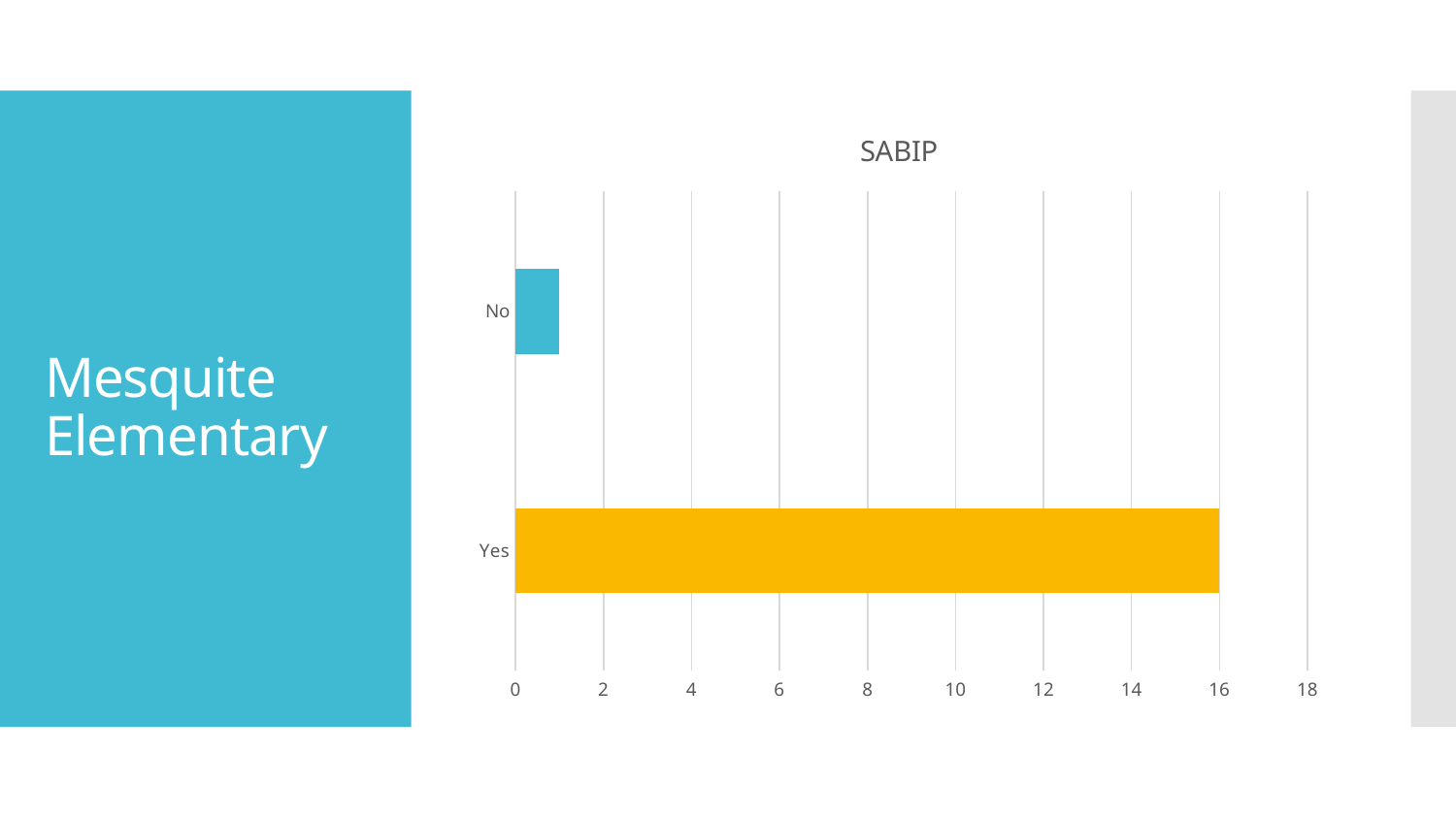
What is the highest value shown on the horizontal axis of the SABIP chart? 18 Which is larger in the SABIP chart, the value for Yes or the value for No? Yes What kind of chart is shown on the slide? bar chart Which category has the lowest value in the SABIP chart? No Is the value for No greater or less than 2 in the SABIP chart? less What colour is the bar for Yes in the SABIP chart? yellow What is the title of the chart on the slide? SABIP What is the value for Yes in the SABIP chart? 16 Is the value for Yes greater or less than 10 in the SABIP chart? greater How many categories are shown in the SABIP chart? 2 Which category has the highest value in the SABIP chart? Yes Is the value for Yes greater or less than 18 in the SABIP chart? less